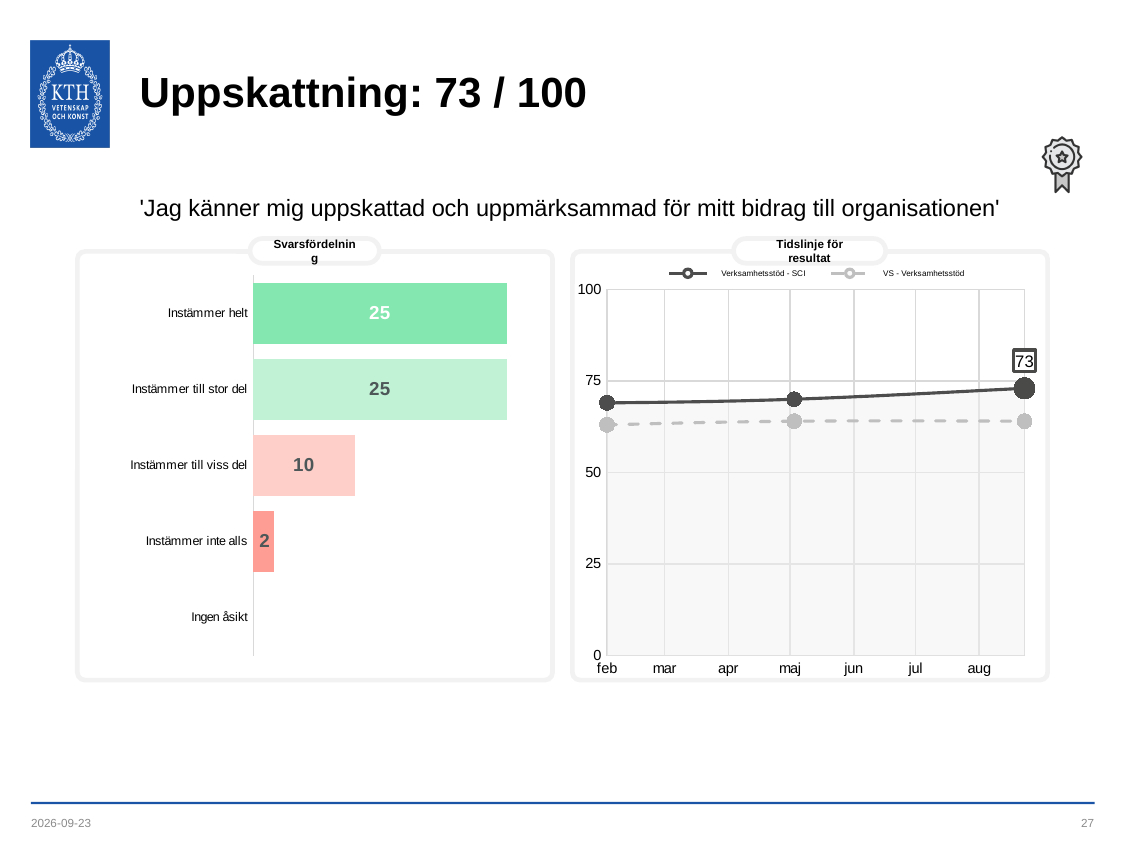
In the Svarsfördelning chart, what is the value for Instämmer till viss del? 10 In the Tidslinje för resultat chart, is the value for VS - Verksamhetsstöd in aug greater or less than 75? less In the Svarsfördelning chart, what is the value for Instämmer inte alls? 2 In the Tidslinje för resultat chart, is the value for Verksamhetsstöd - SCI in feb greater or less than 50? greater In the Svarsfördelning chart, which is larger, Instämmer till viss del or Instämmer inte alls? Instämmer till viss del In the Tidslinje för resultat chart, does the Verksamhetsstöd - SCI line rise or fall from feb to aug? rise In the Tidslinje för resultat chart, what is the labelled value for Verksamhetsstöd - SCI in aug? 73 In the Svarsfördelning chart, what is the value for Instämmer helt? 25 In the Svarsfördelning chart, what is the difference between Instämmer till stor del and Instämmer till viss del? 15 In the Svarsfördelning chart, how many categories are listed on the vertical axis? 5 In the Tidslinje för resultat chart, how many series does the legend list? 2 What kind of chart is the Svarsfördelning chart? bar chart